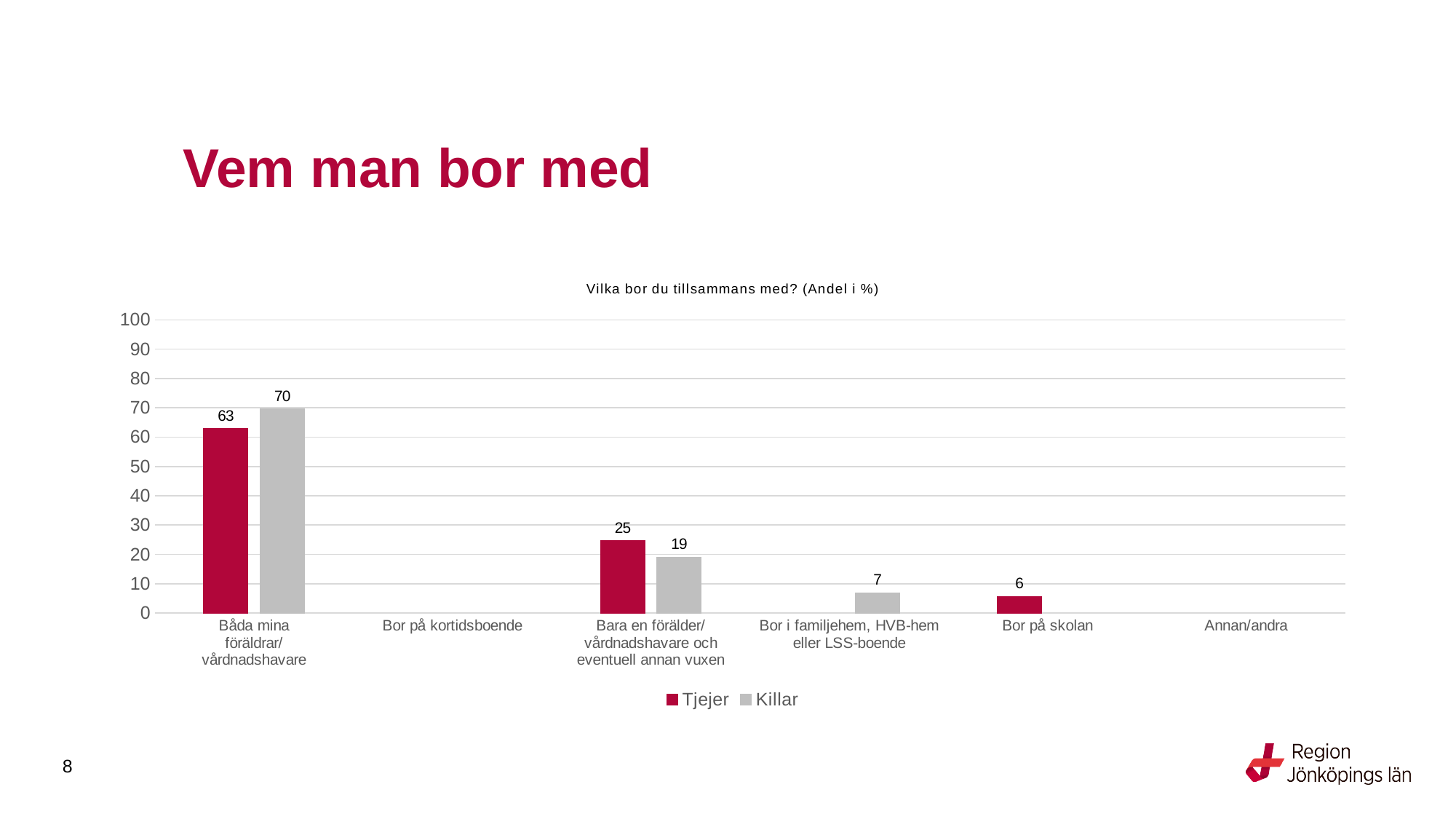
What is the value for Tjejer in the category 'Båda mina föräldrar/vårdnadshavare'? 63 What is the value for Tjejer in the category 'Bor på skolan'? 6 What is the value for Killar in the category 'Båda mina föräldrar/vårdnadshavare'? 70 What kind of chart is shown on the slide? Bar chart How many series does the legend list? 2 What is the difference between the Killar and Tjejer values for 'Båda mina föräldrar/vårdnadshavare'? 7 Which is larger for 'Bara en förälder/vårdnadshavare och eventuell annan vuxen': Tjejer or Killar? Tjejer How many categories are shown on the x axis? 6 Which category has the highest value for Killar? Båda mina föräldrar/vårdnadshavare What is the difference between the Tjejer and Killar values for 'Bara en förälder/vårdnadshavare och eventuell annan vuxen'? 6 What is the value for Tjejer in the category 'Bara en förälder/vårdnadshavare och eventuell annan vuxen'? 25 What is the value for Killar in the category 'Bor i familjehem, HVB-hem eller LSS-boende'? 7